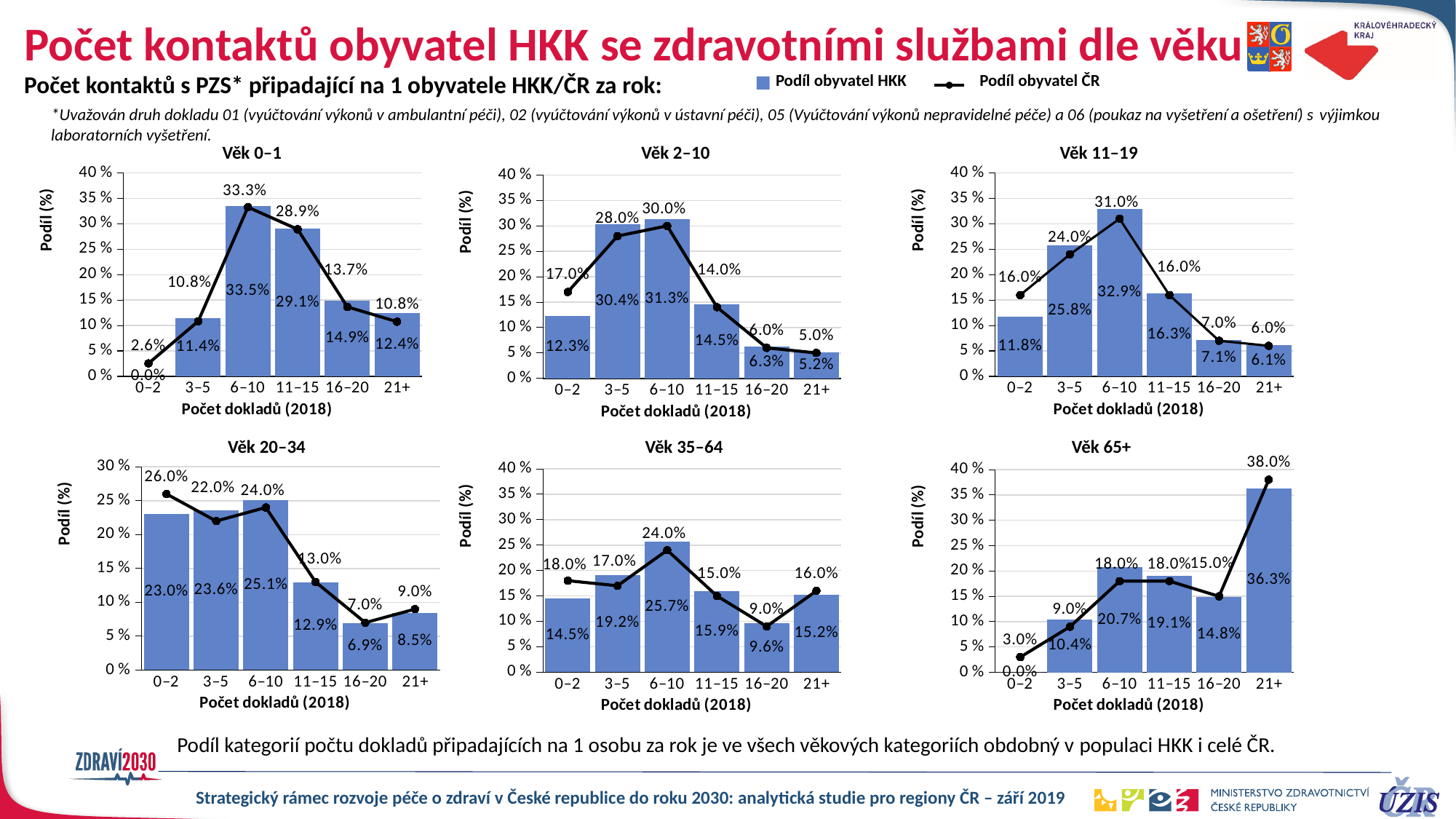
In the 'Věk 0–1' chart, what is the HKK share (bar) for the '6–10' category? 33.5% In the 'Věk 65+' chart, which category has the highest HKK share (bar)? 21+ In the 'Věk 65+' chart, do the HKK bar values rise or fall from '16–20' to '21+'? Rise In the 'Věk 11–19' chart, which category has the lowest HKK share (bar)? 21+ In the 'Věk 2–10' chart, what is the ČR share (line) for the '0–2' category? 17.0% How many categories are shown on the x axis of the 'Věk 65+' chart? 6 In the 'Věk 20–34' chart, which is larger for the '0–2' category: the HKK share (bar) or the ČR share (line)? ČR share (line) In the 'Věk 11–19' chart, what is the ČR share (line) for the '3–5' category? 24.0% What kind of chart is used for the 'Podíl obyvatel HKK' series in the 'Věk 2–10' chart? Bar chart In the 'Věk 35–64' chart, what is the difference between the HKK share (bar) and the ČR share (line) for the '6–10' category? 1.7% What is the x-axis title of the 'Věk 35–64' chart? Počet dokladů (2018) How many series does the legend list? 2